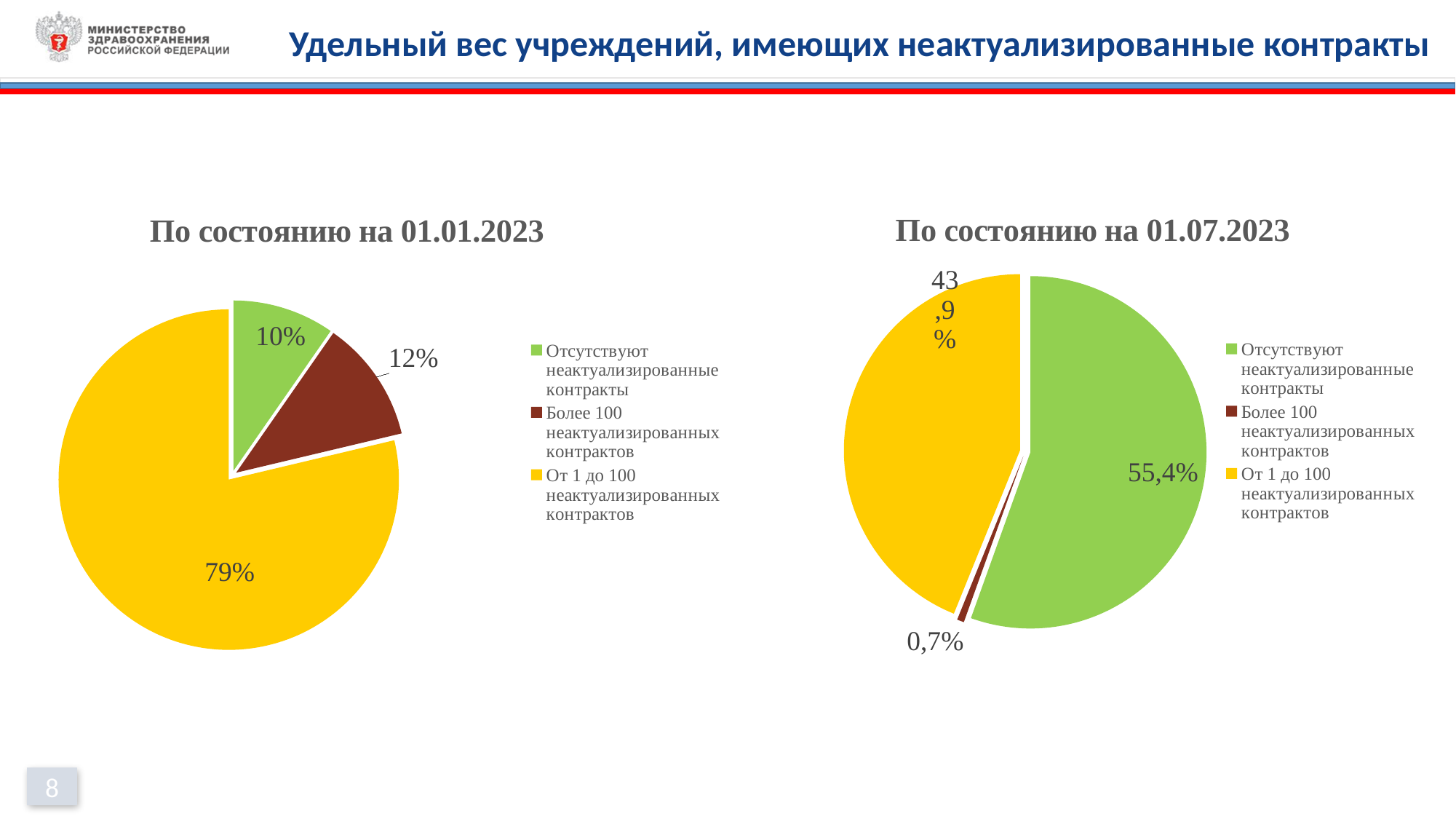
In the chart titled "По состоянию на 01.07.2023", which category has the largest slice? Отсутствуют неактуализированные контракты In the chart titled "По состоянию на 01.07.2023", what share is shown for "От 1 до 100 неактуализированных контрактов"? 43,9% In the chart titled "По состоянию на 01.07.2023", which category has the smallest slice? Более 100 неактуализированных контрактов In the chart titled "По состоянию на 01.01.2023", what share is shown for "От 1 до 100 неактуализированных контрактов"? 79% What type of chart is the chart titled "По состоянию на 01.07.2023"? Pie chart In the chart titled "По состоянию на 01.01.2023", what share is shown for "Более 100 неактуализированных контрактов"? 12% In the chart titled "По состоянию на 01.01.2023", which category has the largest slice? От 1 до 100 неактуализированных контрактов In the chart titled "По состоянию на 01.07.2023", what share is shown for "Отсутствуют неактуализированные контракты"? 55,4% In the chart titled "По состоянию на 01.07.2023", what share is shown for "Более 100 неактуализированных контрактов"? 0,7% How many categories does the legend of the chart titled "По состоянию на 01.01.2023" list? 3 In the chart titled "По состоянию на 01.01.2023", what share is shown for "Отсутствуют неактуализированные контракты"? 10% In the chart titled "По состоянию на 01.01.2023", what is the difference between the shares for "Более 100 неактуализированных контрактов" and "Отсутствуют неактуализированные контракты"? 2%